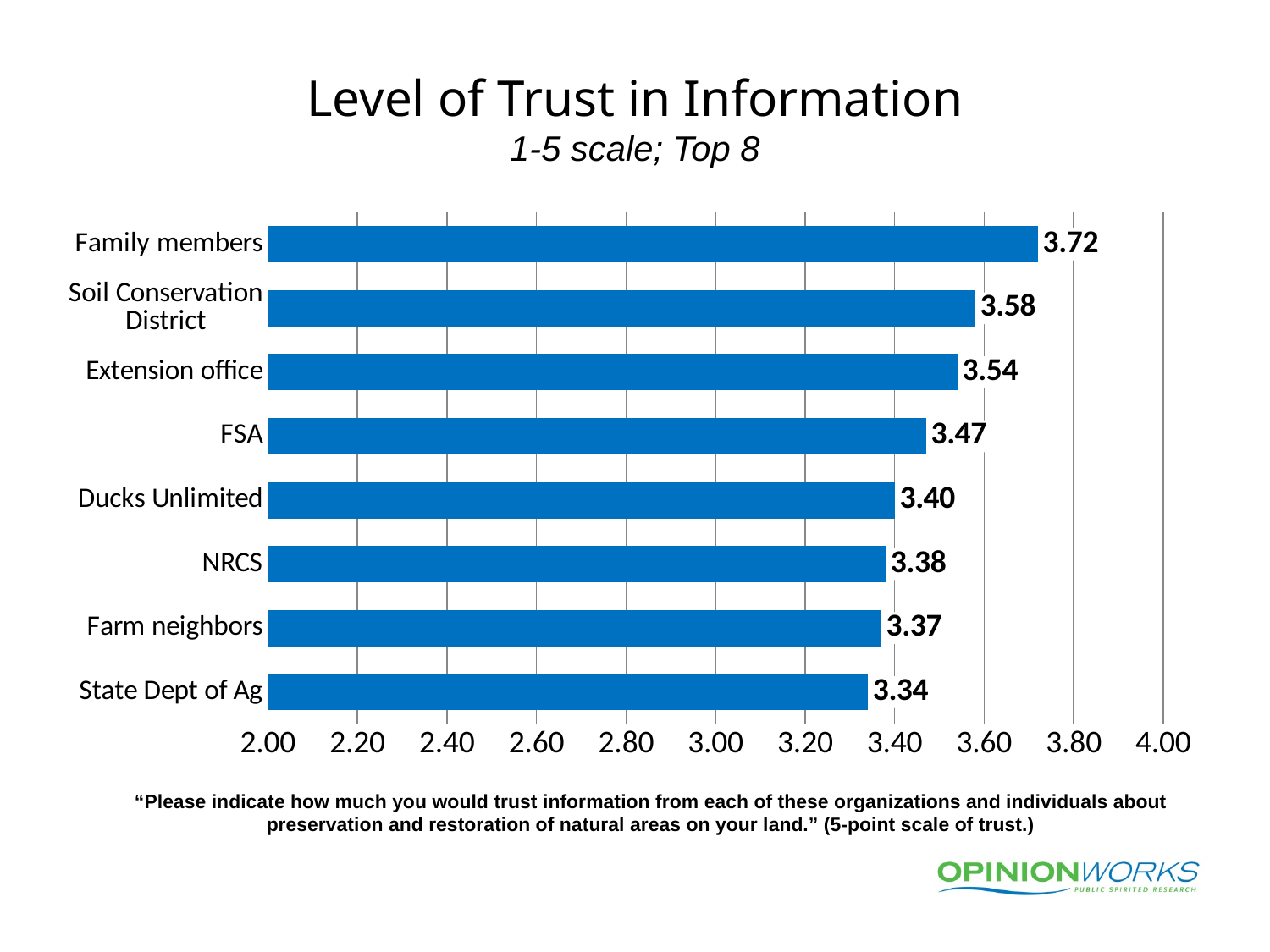
Which has a higher level of trust, Ducks Unlimited or Farm neighbors? Ducks Unlimited What is the difference between the values for Family members and State Dept of Ag? 0.38 Which category has the highest level of trust? Family members What is the title of the chart? Level of Trust in Information What is the level of trust value for Family members? 3.72 Which category has the lowest level of trust? State Dept of Ag Is the value for FSA greater or less than 3.40? greater How many categories are shown in the chart? 8 What is the difference between the values for Soil Conservation District and FSA? 0.11 What is the level of trust value for NRCS? 3.38 What kind of chart is shown on the slide? Bar chart What is the level of trust value for Extension office? 3.54